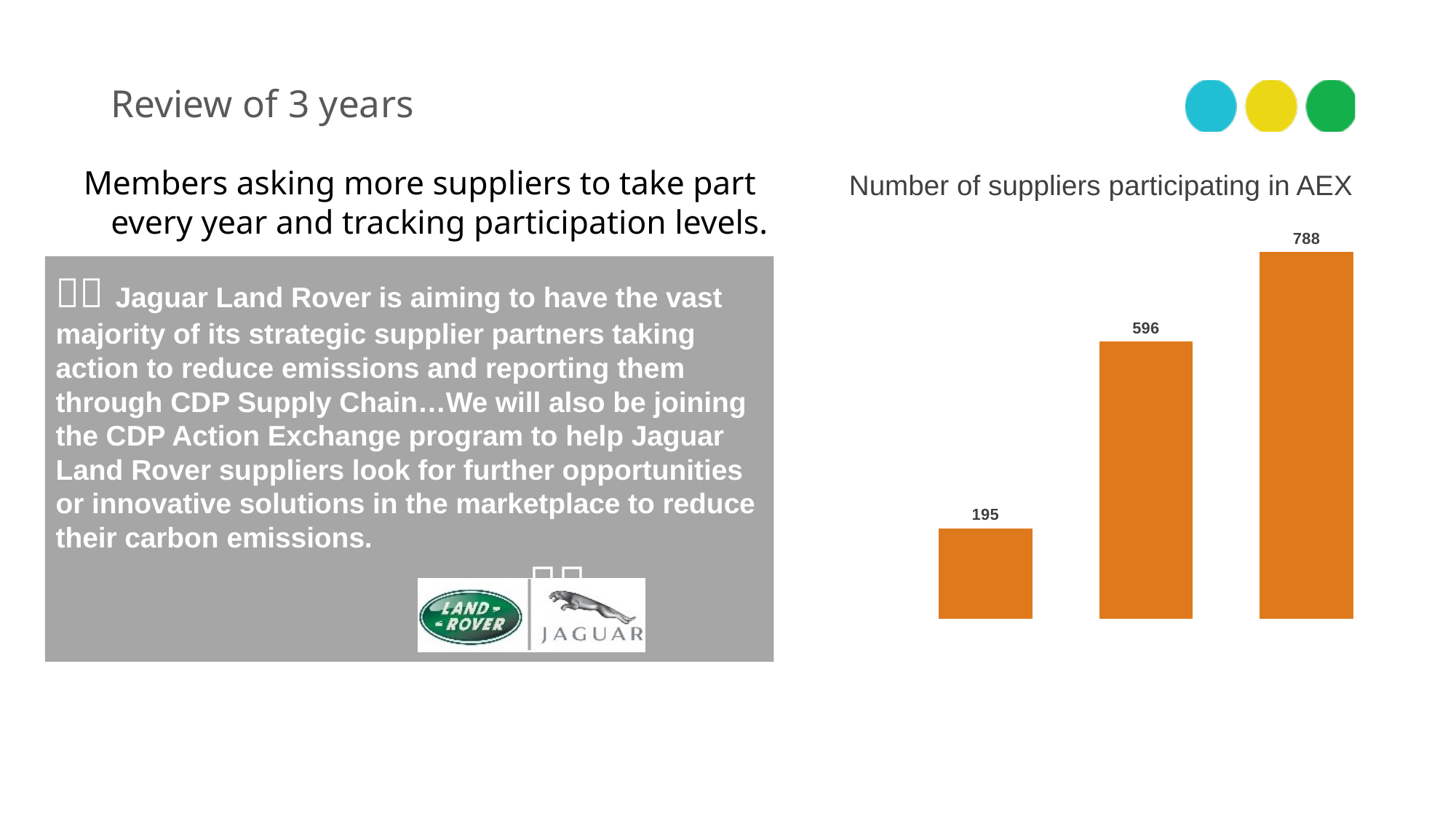
Which is larger, the middle bar or the rightmost bar? the rightmost bar How many bars are plotted in the chart? 3 Which bar has the lowest value: the first, second or third? first What is the value of the middle bar in the chart? 596 What is the difference between the rightmost bar and the leftmost bar? 593 What is the value of the rightmost bar in the chart? 788 Which bar has the highest value: the first, second or third? third What is the difference between the middle bar and the leftmost bar? 401 What kind of chart is shown on the slide? bar chart Do the values rise or fall from left to right across the chart? rise What is the difference between the rightmost bar and the middle bar? 192 What is the value of the leftmost bar in the chart? 195